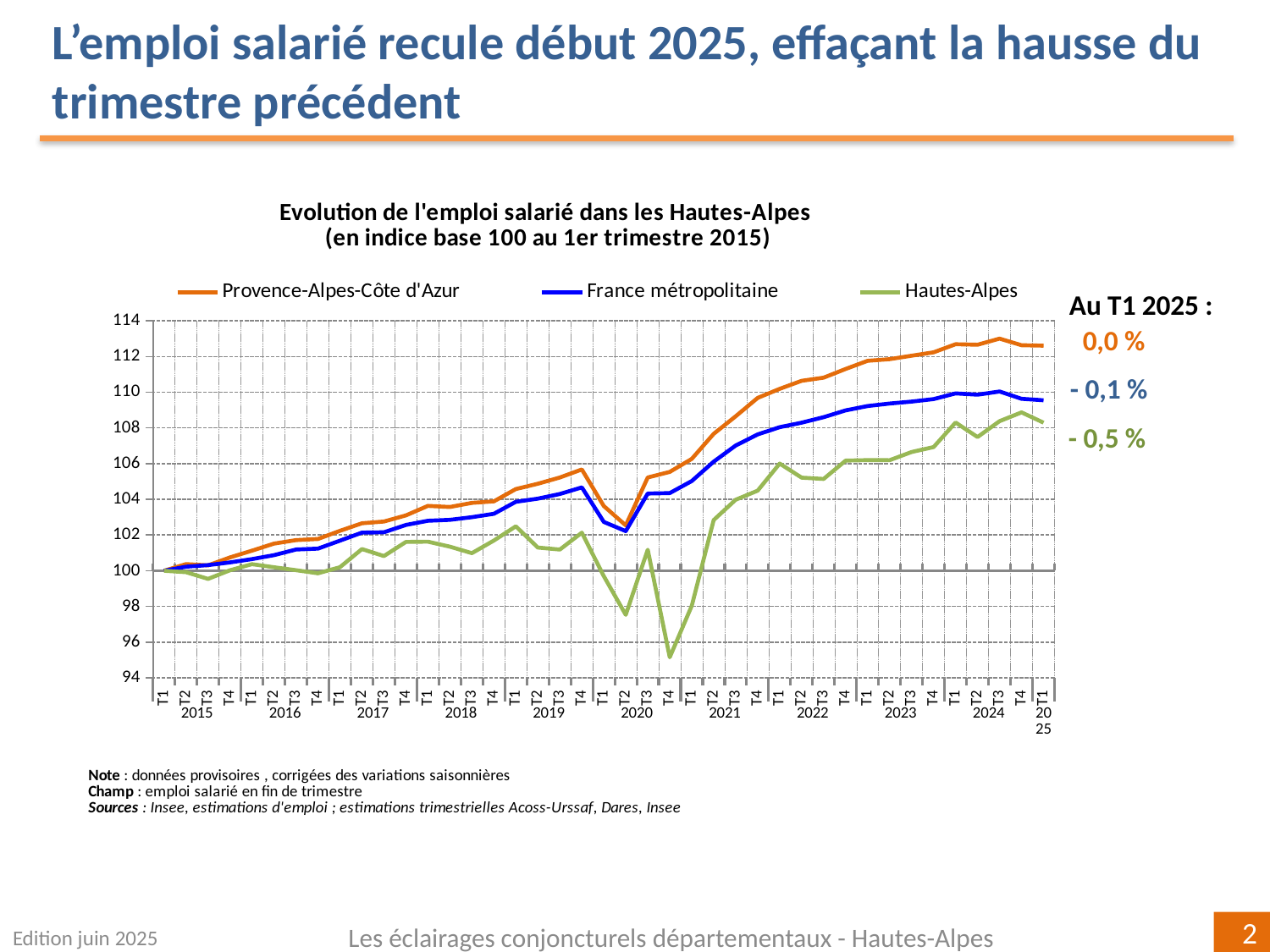
Is the value for Hautes-Alpes at T4 2020 greater or less than 98? less What change is annotated for France métropolitaine at T1 2025? - 0,1 % Does the Provence-Alpes-Côte d'Azur series rise or fall overall from T1 2015 to T4 2024? rise What is the index value of Hautes-Alpes at T1 2015? 100 What is the title of the chart? Evolution de l'emploi salarié dans les Hautes-Alpes (en indice base 100 au 1er trimestre 2015) How many series does the legend list? 3 Is the value for Provence-Alpes-Côte d'Azur at T1 2025 greater or less than 112? greater Which series has the lowest index value at T4 2020? Hautes-Alpes What change is annotated for Hautes-Alpes at T1 2025? - 0,5 % What kind of chart is shown on the slide? line chart Which series is drawn in orange? Provence-Alpes-Côte d'Azur Which series has the highest index value at T1 2025? Provence-Alpes-Côte d'Azur